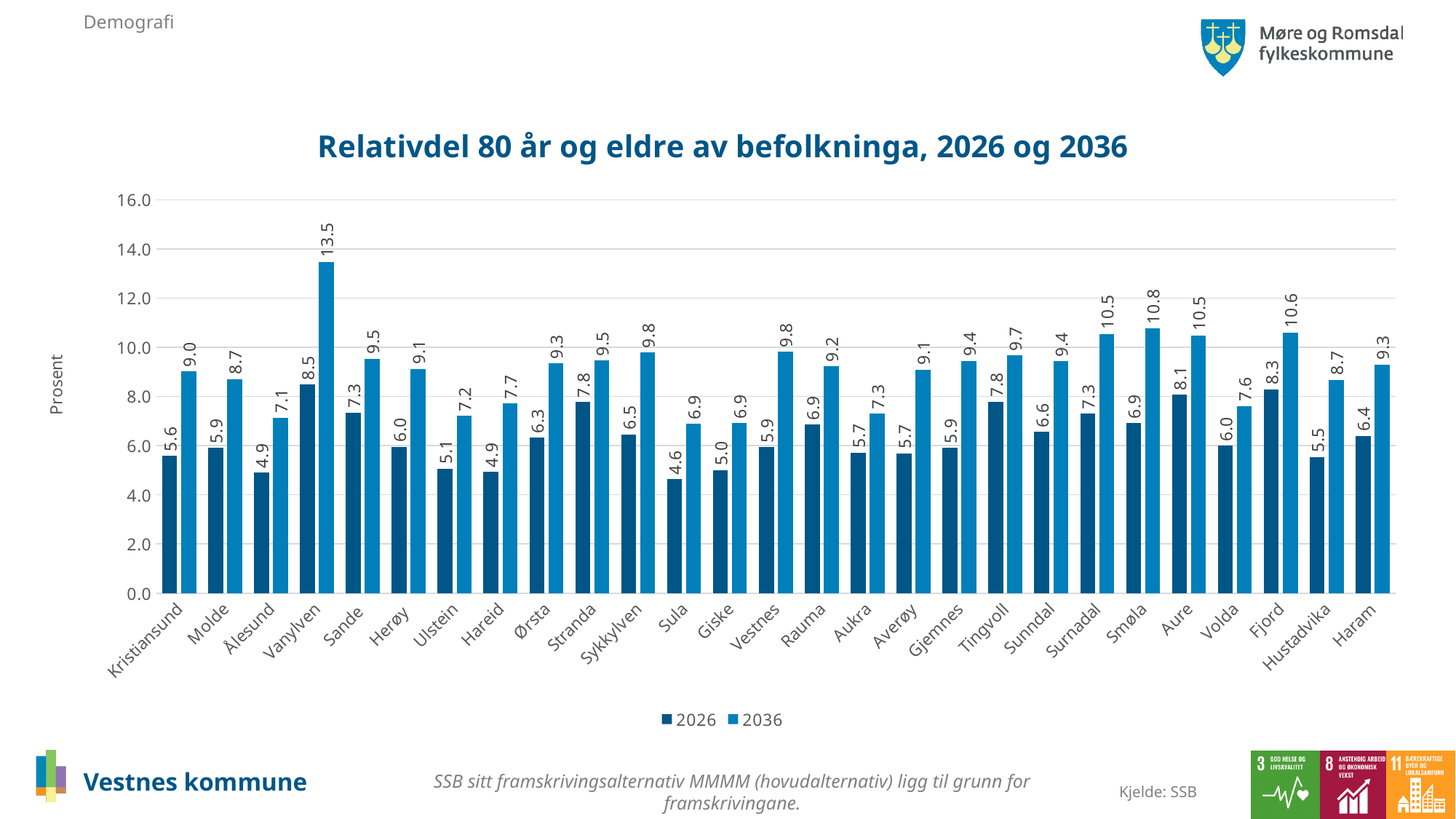
How many series does the legend list? 2 What is the value for Vanylven in the 2026 series? 8.5 How many municipalities are shown on the x axis? 27 Which municipality has the lowest value in the 2026 series? Sula What is the difference between the 2036 values for Vanylven and Smøla? 2.7 Is the 2036 value for Surnadal greater or less than 10.0? greater What is the value for Hustadvika in the 2036 series? 8.7 What is the value for Vestnes in the 2036 series? 9.8 What kind of chart is shown on the slide? Bar chart What is the difference between the 2036 and 2026 values for Vestnes? 3.9 Which municipality has the highest value in the 2036 series? Vanylven Which is larger, the 2026 value for Fjord or the 2026 value for Aure? Fjord